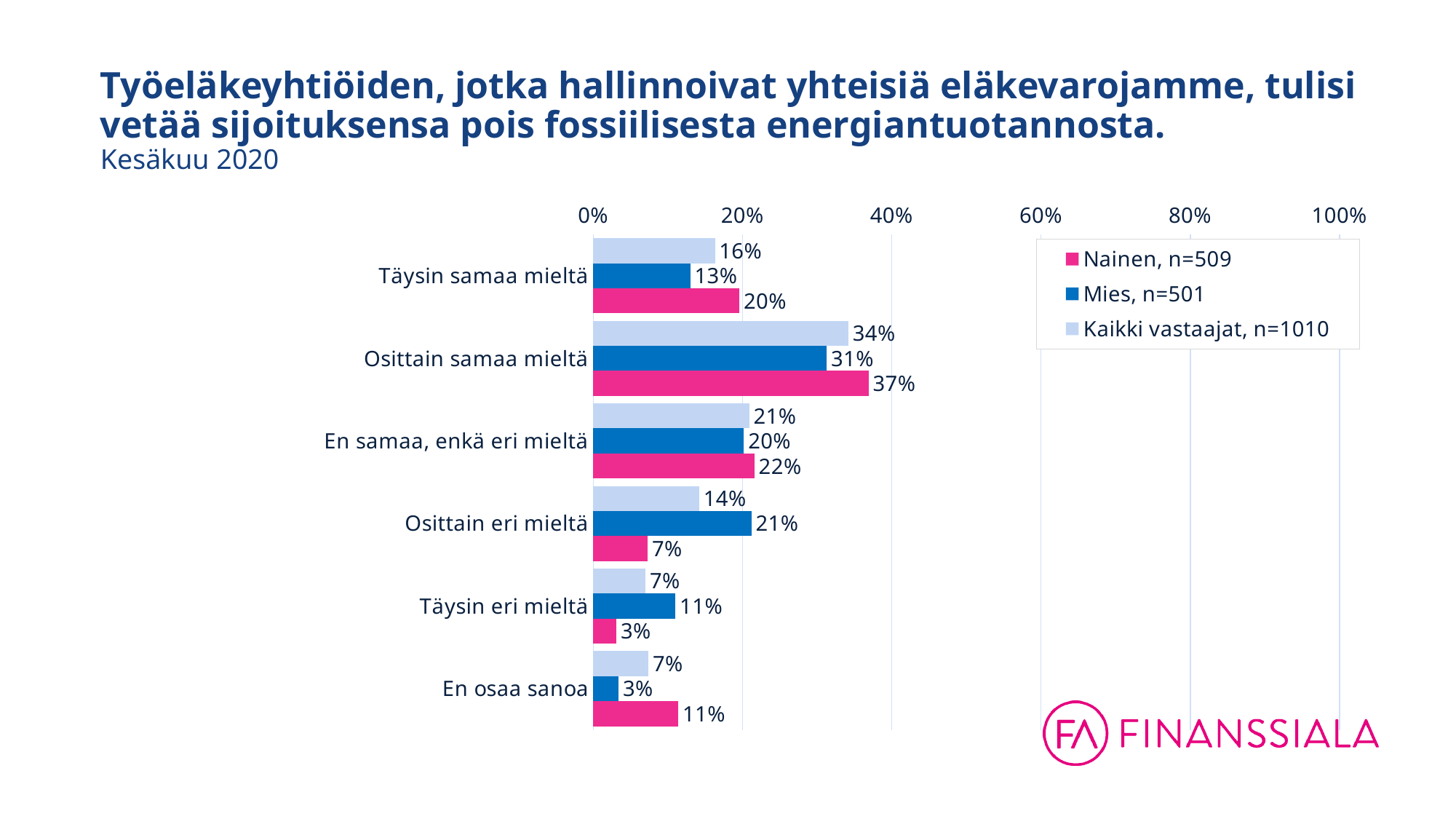
What percentage of Nainen respondents answered "Osittain samaa mieltä"? 37% How many response categories are shown on the chart? 6 What is the difference between the Mies and Nainen values for "Osittain eri mieltä"? 14 percentage points What is the value for Kaikki vastaajat in the "En samaa, enkä eri mieltä" category? 21% Which category has the highest value for Kaikki vastaajat? Osittain samaa mieltä How many series does the legend list? 3 What is the value for Mies in the "Täysin eri mieltä" category? 11% According to the legend, how many respondents are in the Mies group? 501 What kind of chart is shown on the slide? Bar chart Is the Nainen value for "Osittain samaa mieltä" greater or less than 40%? less Which category has the lowest value for Nainen? Täysin eri mieltä Which is larger for "En osaa sanoa": the Nainen value or the Mies value? Nainen